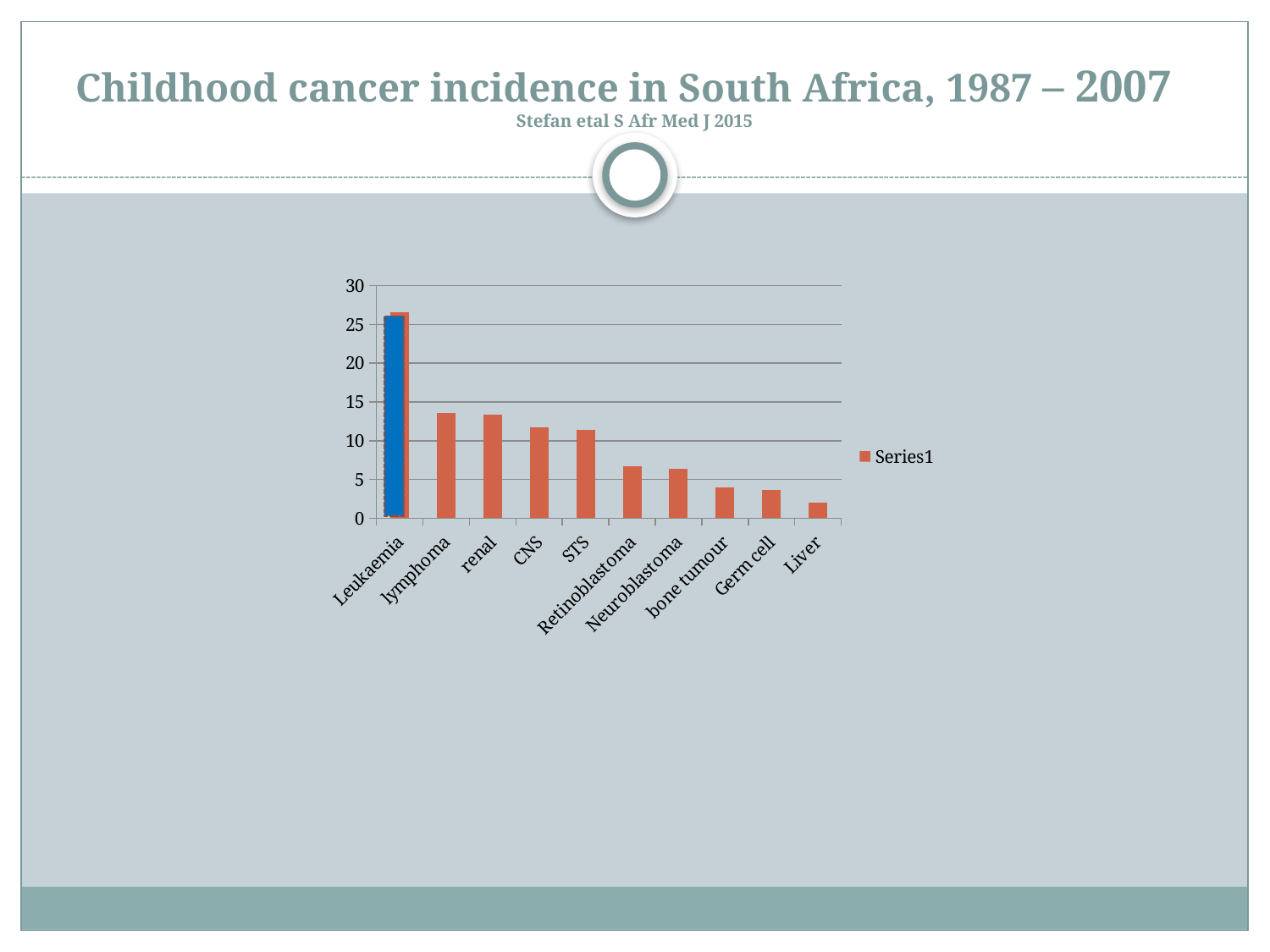
What kind of chart is shown on the slide? bar chart Is the value for Retinoblastoma greater or less than 10? less How many series does the chart legend list? 1 Which is larger, the value for Leukaemia or the value for lymphoma? Leukaemia Which category has the lowest value in the chart? Liver Which category has the highest value in the chart? Leukaemia Do the values rise or fall moving from left to right along the x axis? fall Which is larger, the value for STS or the value for Retinoblastoma? STS Is the value for Liver greater or less than 5? less Is the value for Leukaemia greater or less than 25? greater How many categories are plotted on the x axis of the chart? 10